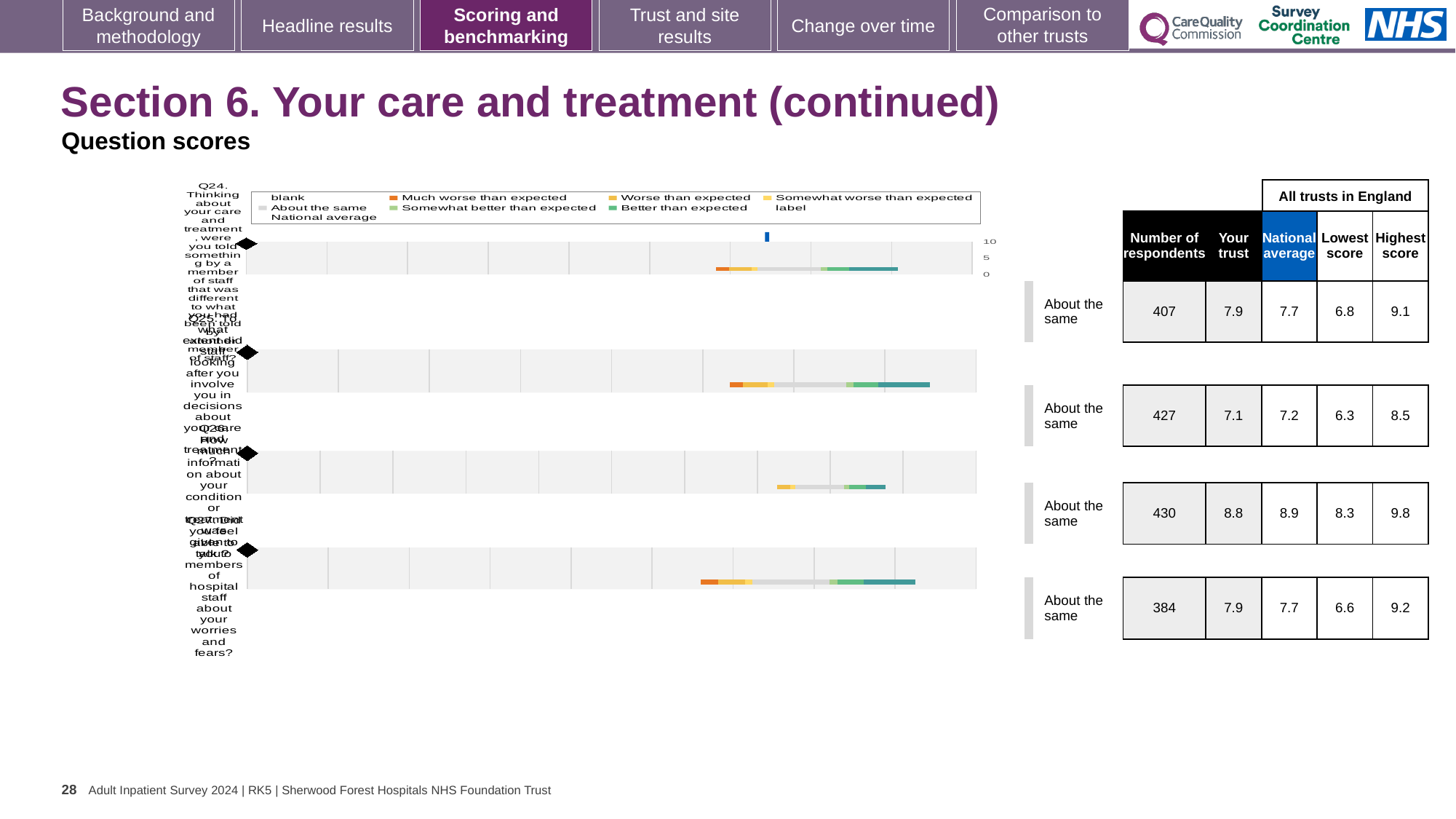
How many questions (rows) are plotted in the chart? 4 What is the difference between the highest score and the lowest score for Q26? 1.5 What kind of chart is used to show the question scores on this slide? bar chart What benchmark category is shown for Q24 next to the chart? About the same In the table next to the chart, what is the national average for Q26? 8.9 In the table next to the chart, what is the number of respondents for Q25? 427 For Q25, which is larger: the 'Your trust' score or the national average? National average In the table next to the chart, what is the 'Your trust' score for Q24? 7.9 Which question has the highest 'Your trust' score in the table? Q26 In the table next to the chart, what is the highest score for Q27? 9.2 Which question has the lowest number of respondents in the table? Q27 What is the heading above the 'National average', 'Lowest score' and 'Highest score' columns in the table? All trusts in England